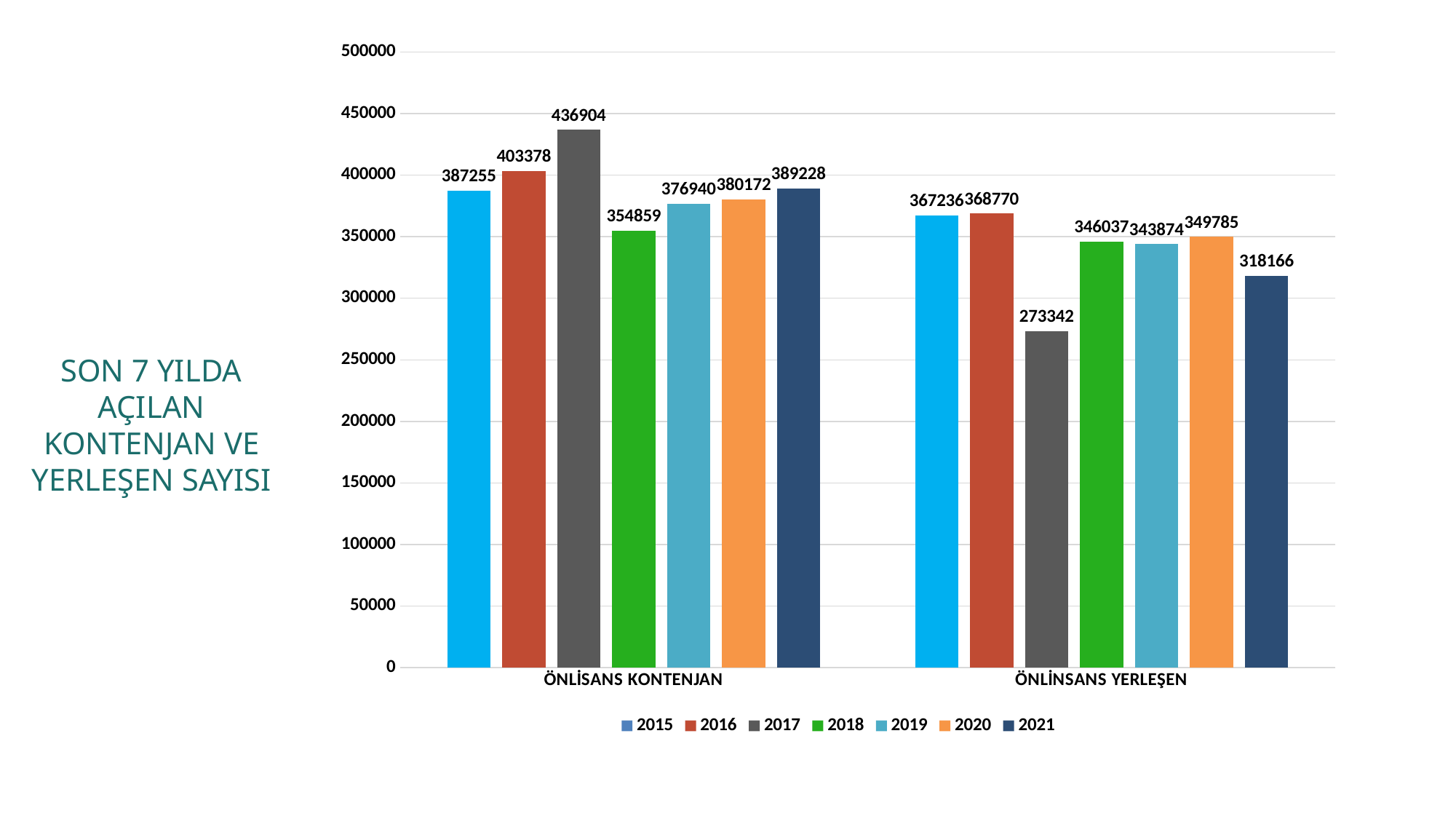
What is the value for 2017 in the ÖNLİSANS KONTENJAN group? 436904 Is the 2017 value for ÖNLİNSANS YERLEŞEN greater or less than 300000? less Which year has the lowest value in the ÖNLİNSANS YERLEŞEN group? 2017 Which is larger: the 2016 value for ÖNLİSANS KONTENJAN or the 2021 value for ÖNLİSANS KONTENJAN? 2016 value for ÖNLİSANS KONTENJAN Which year has the highest value in the ÖNLİSANS KONTENJAN group? 2017 What kind of chart is shown on the slide? bar chart What is the difference between the 2021 value for ÖNLİSANS KONTENJAN and the 2021 value for ÖNLİNSANS YERLEŞEN? 71062 What is the value for 2019 in the ÖNLİSANS KONTENJAN group? 376940 What is the value for 2021 in the ÖNLİNSANS YERLEŞEN group? 318166 How many series does the legend list? 7 Which year has the lowest value in the ÖNLİSANS KONTENJAN group? 2018 What is the difference between the 2017 value for ÖNLİSANS KONTENJAN and the 2017 value for ÖNLİNSANS YERLEŞEN? 163562